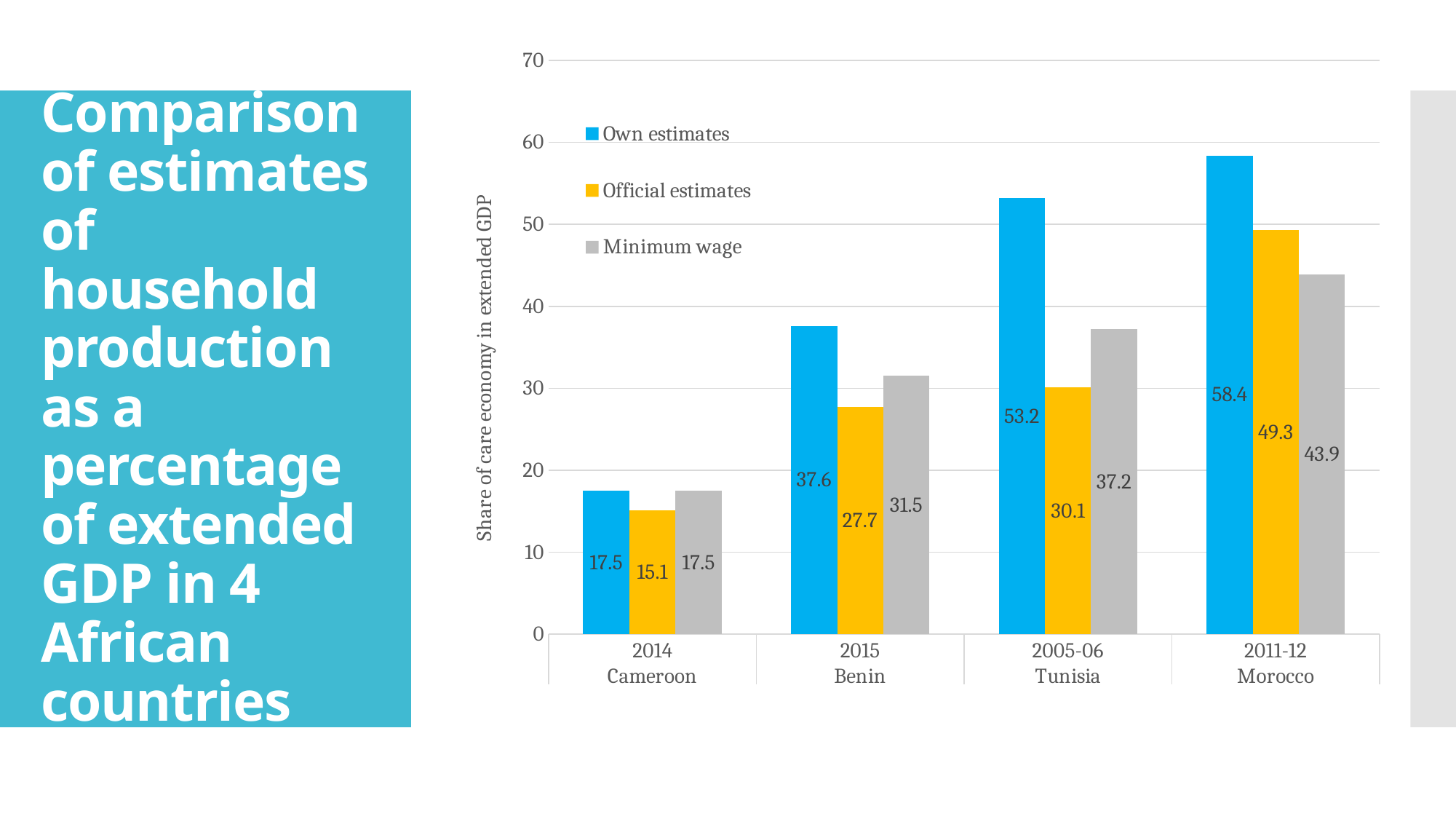
Which is larger for Benin: the Official estimates value or the Minimum wage value? Minimum wage How many series does the legend list? 3 What is the Official estimates value for Benin (2015)? 27.7 What is the Own estimates value for Morocco (2011-12)? 58.4 What is the label of the vertical axis? Share of care economy in extended GDP What is the Minimum wage value for Tunisia (2005-06)? 37.2 How many countries are shown on the x axis? 4 Which country has the highest Own estimates value? Morocco What is the difference between the Own estimates and Official estimates values for Tunisia? 23.1 Which country has the lowest Official estimates value? Cameroon Is the Own estimates value for Tunisia greater or less than 50? greater What kind of chart is shown on the slide? bar chart